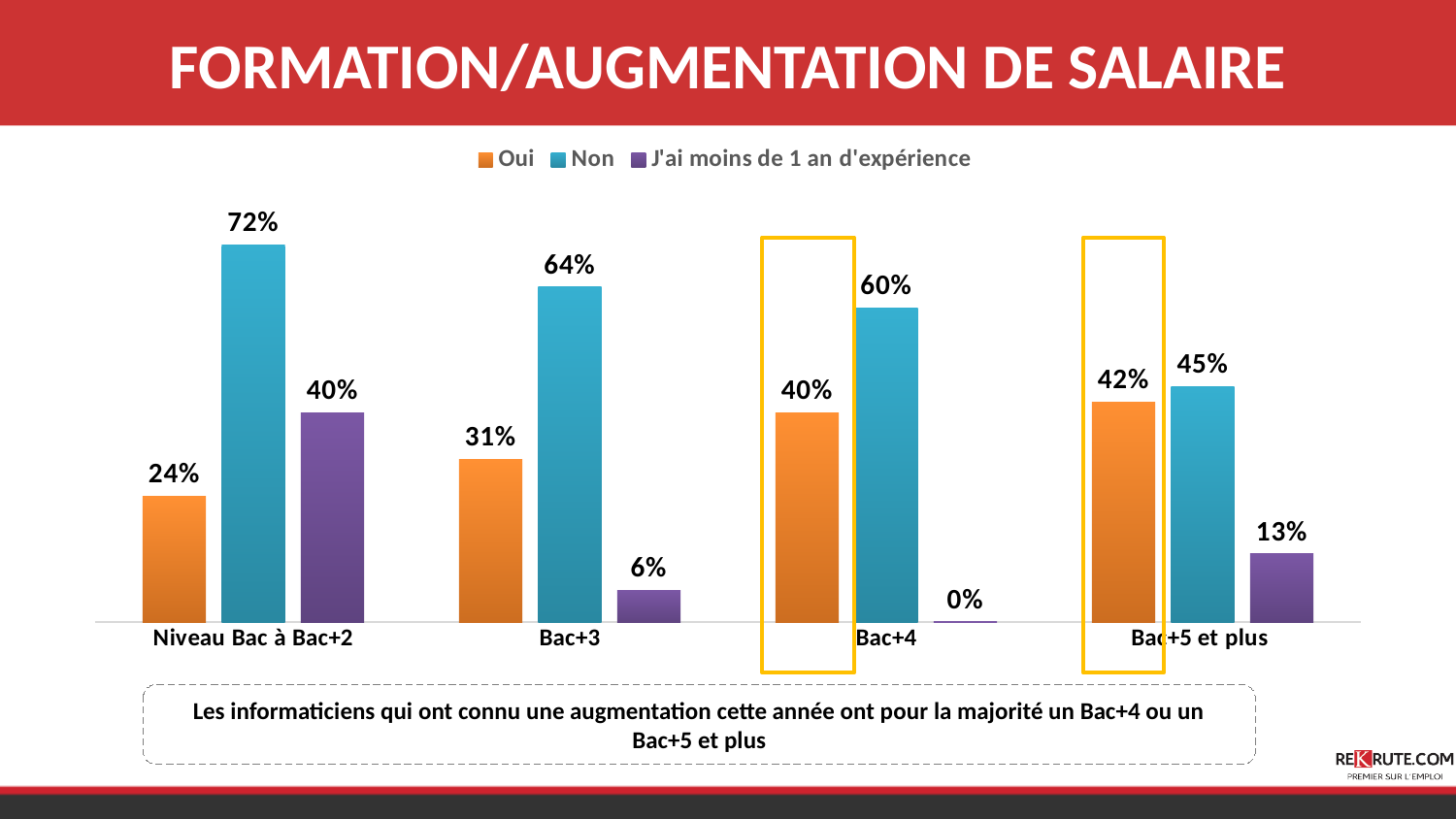
What is the value of "Non" for Niveau Bac à Bac+2? 72% Which colour represents the "Oui" series? Orange Which is larger for Bac+5 et plus: "Oui" or "Non"? Non Does the "Non" value rise or fall from Niveau Bac à Bac+2 to Bac+5 et plus? Fall What is the difference between the "Non" and "Oui" values for Bac+3? 33% What kind of chart is shown on the slide? Bar chart What is the value of "J'ai moins de 1 an d'expérience" for Bac+5 et plus? 13% How many education level categories are shown on the x axis? 4 How many series does the legend list? 3 Which education level has the highest "Oui" value? Bac+5 et plus Which education level has the lowest "J'ai moins de 1 an d'expérience" value? Bac+4 What is the value of "Oui" for Bac+4? 40%